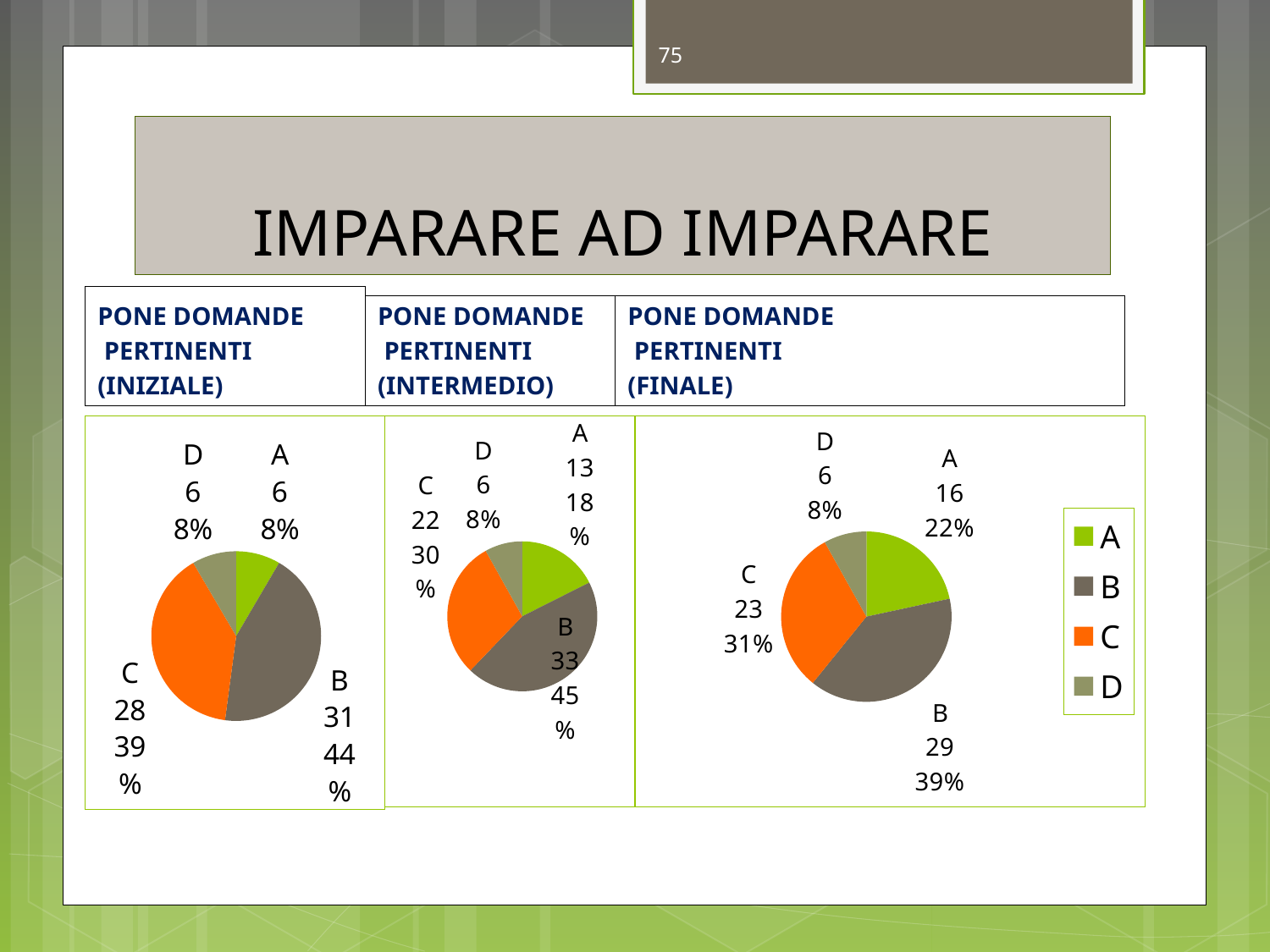
In the PONE DOMANDE PERTINENTI (INTERMEDIO) pie chart, what is the value for category A? 13 In the PONE DOMANDE PERTINENTI (FINALE) pie chart, what is the value for category B? 29 In the PONE DOMANDE PERTINENTI (FINALE) pie chart, what percentage does category C represent? 31% In the PONE DOMANDE PERTINENTI (FINALE) pie chart, what is the difference between the values for B and A? 13 What type of chart is used for PONE DOMANDE PERTINENTI (FINALE)? Pie chart What colour represents category C in the legend on the slide? Orange In the PONE DOMANDE PERTINENTI (INTERMEDIO) pie chart, which category has the largest share? B In the PONE DOMANDE PERTINENTI (INIZIALE) pie chart, what is the value for category C? 28 In the PONE DOMANDE PERTINENTI (FINALE) pie chart, which category has the smallest share? D How many categories does the PONE DOMANDE PERTINENTI (INIZIALE) pie chart show? 4 In the PONE DOMANDE PERTINENTI (INIZIALE) pie chart, what percentage does category B represent? 44% In the PONE DOMANDE PERTINENTI (INTERMEDIO) pie chart, which is larger, the value for C or the value for A? C